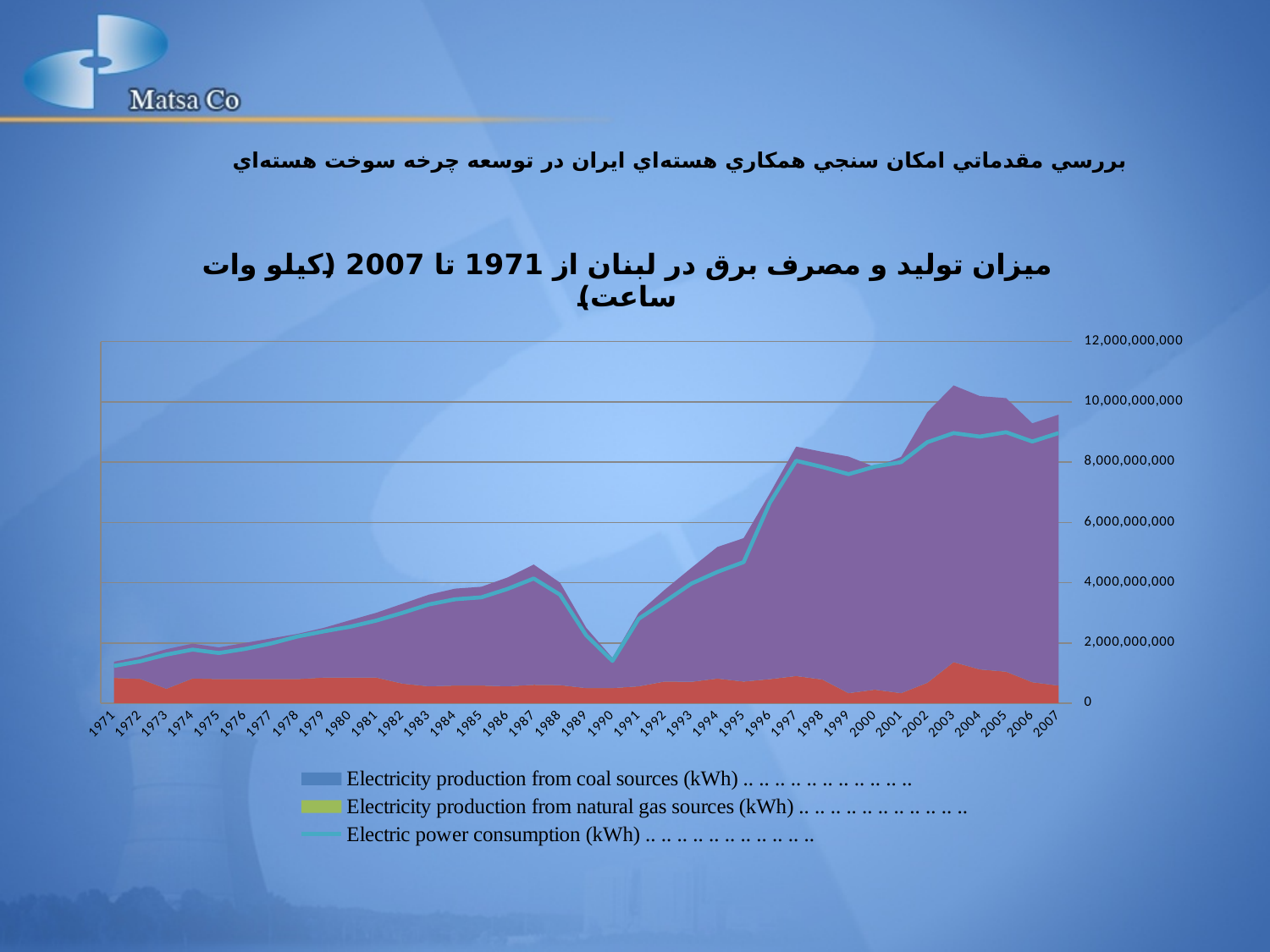
Is the Electric power consumption (kWh) value for 1980 greater or less than 4,000,000,000? less Does Electric power consumption (kWh) rise or fall between 1987 and 1990? fall Is the Electric power consumption (kWh) value for 1990 greater or less than 2,000,000,000? less Does Electric power consumption (kWh) generally rise or fall from 1971 to 2007? rise Is the Electric power consumption (kWh) value for 2007 greater or less than 8,000,000,000? greater How many years are shown along the x axis? 37 What is the first year shown on the x axis? 1971 What is the highest value shown on the y axis? 12,000,000,000 How many series does the legend list? 3 What kind of chart is shown on the slide? Area and line chart